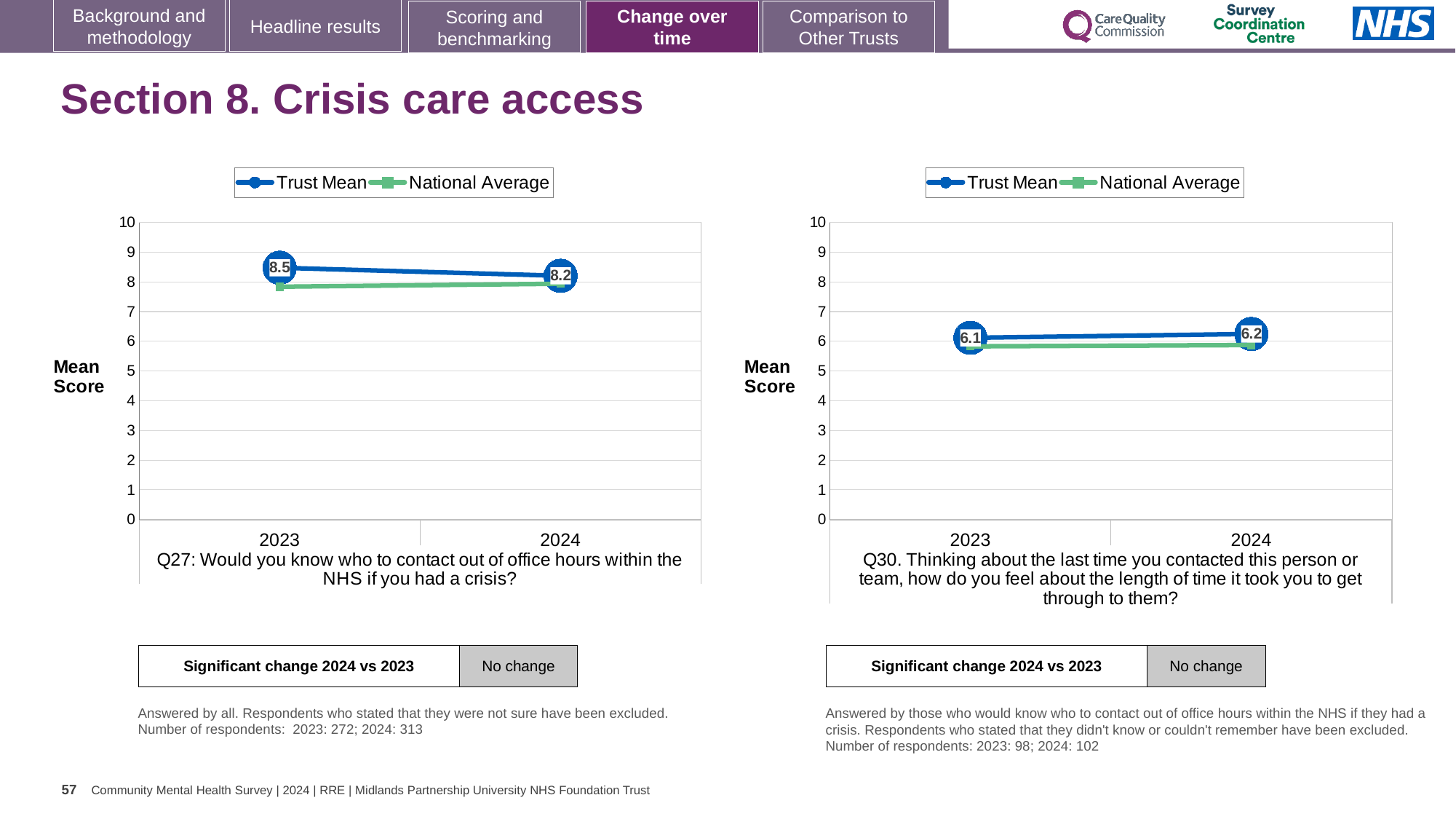
In the left chart (Q27), what is the Trust Mean score for 2023? 8.5 In the left chart (Q27), which is larger for 2023: the Trust Mean or the National Average? Trust Mean In the left chart (Q27), what is the Trust Mean score for 2024? 8.2 In the right chart (Q30), does the Trust Mean rise or fall from 2023 to 2024? rise In the right chart (Q30), is the National Average value for 2023 greater or less than 7? less In the right chart (Q30), what is the Trust Mean score for 2023? 6.1 In the left chart (Q27), by how much did the Trust Mean change from 2023 to 2024? 0.3 How many years are shown on the x axis of the left chart (Q27)? 2 In the left chart (Q27), does the Trust Mean rise or fall from 2023 to 2024? fall In the right chart (Q30), what is the Trust Mean score for 2024? 6.2 What kind of chart is the left chart (Q27)? line chart How many series does the legend of the right chart (Q30) list? 2